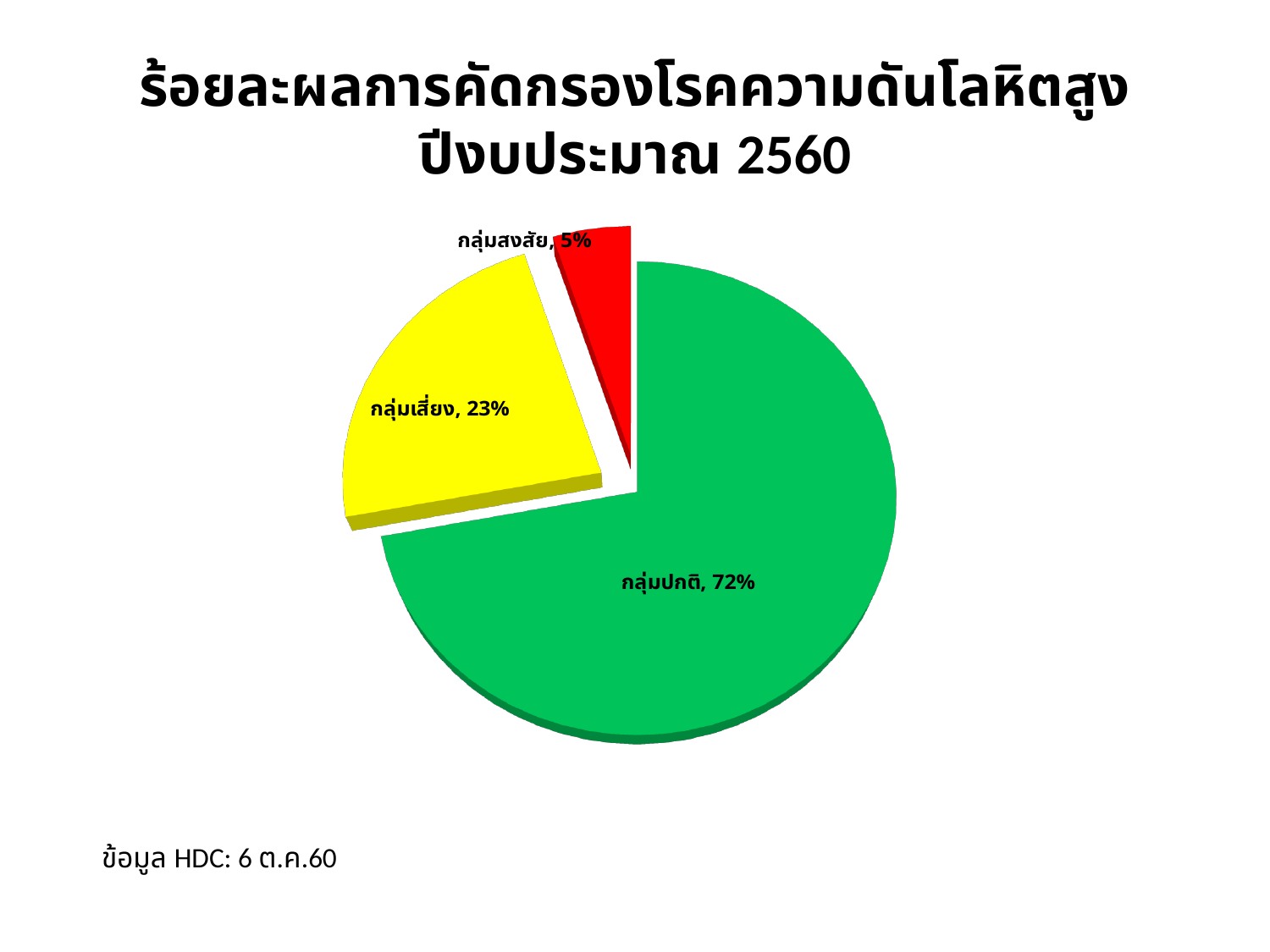
What is the share for กลุ่มปกติ? 72% What colour is the slice for กลุ่มปกติ? green Which group has the largest slice of the pie? กลุ่มปกติ What is the difference in percentage points between กลุ่มปกติ and กลุ่มเสี่ยง? 49 Which group has the smallest slice of the pie? กลุ่มสงสัย What is the difference in percentage points between กลุ่มเสี่ยง and กลุ่มสงสัย? 18 What is the title of the chart? ร้อยละผลการคัดกรองโรคความดันโลหิตสูง ปีงบประมาณ 2560 What is the share for กลุ่มเสี่ยง? 23% How many slices does the pie chart have? 3 What is the share for กลุ่มสงสัย? 5% What kind of chart is shown on the slide? pie chart Which is larger, the share for กลุ่มเสี่ยง or the share for กลุ่มสงสัย? กลุ่มเสี่ยง